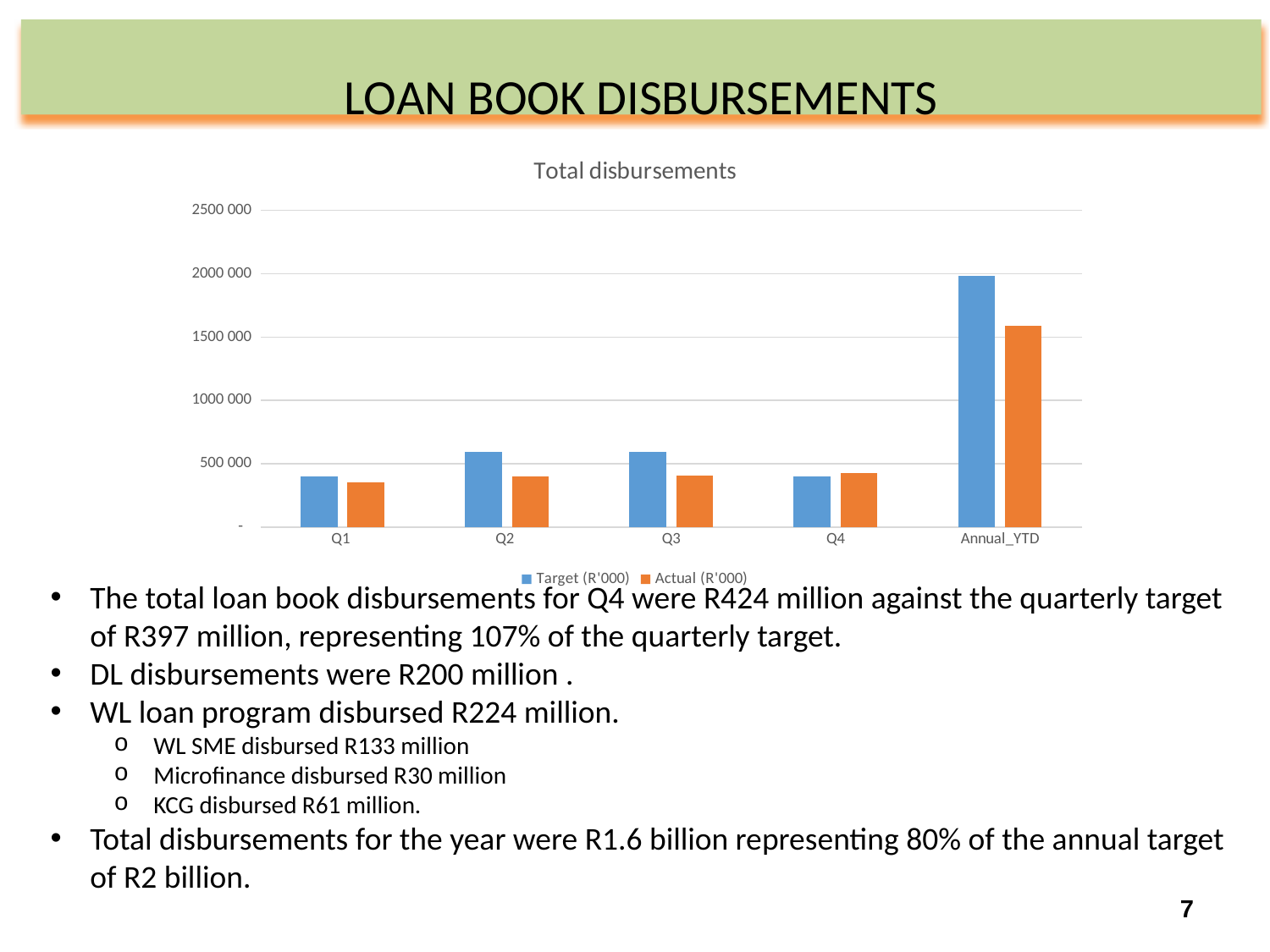
Which colour represents the Actual (R'000) series in the chart? orange How many series does the chart legend list? 2 Which category has the highest Target (R'000) value? Annual_YTD What is the title of the chart? Total disbursements What kind of chart is shown on the slide? bar chart Is the Target (R'000) value for Q2 greater or less than 500 000? greater Is the Actual (R'000) value for Q1 greater or less than 500 000? less For Q3, which is larger: Target (R'000) or Actual (R'000)? Target (R'000) Which category has the lowest Actual (R'000) value? Q1 Is the Target (R'000) value for Annual_YTD greater or less than 1500 000? greater How many categories are shown on the x axis of the chart? 5